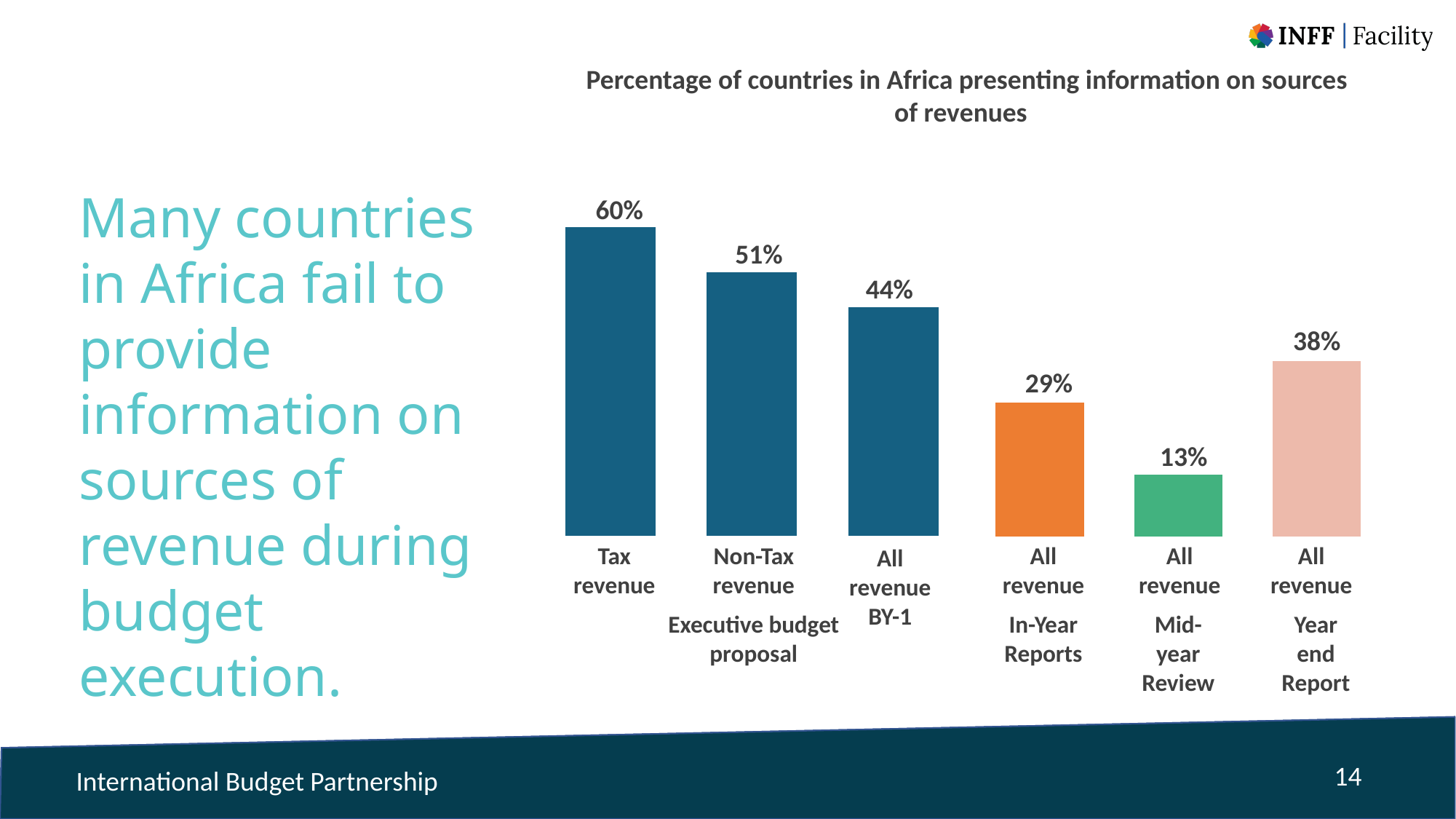
What percentage of countries in Africa present information on tax revenue in the Executive budget proposal? 60% What is the difference between the tax revenue value and the non-tax revenue value in the Executive budget proposal? 9% What is the value for all revenue in In-Year Reports? 29% What is the value for non-tax revenue in the Executive budget proposal? 51% Which category has the lowest percentage? All revenue, Mid-year Review What type of chart is shown on the slide? Bar chart What is the value for all revenue in the Year end Report? 38% How many bars are shown in the chart? 6 What is the value for all revenue in the Mid-year Review? 13% Which is larger: the value for all revenue in the Year end Report or in In-Year Reports? Year end Report What percentage of countries present all revenue for BY-1? 44% Which category has the highest percentage? Tax revenue (Executive budget proposal)